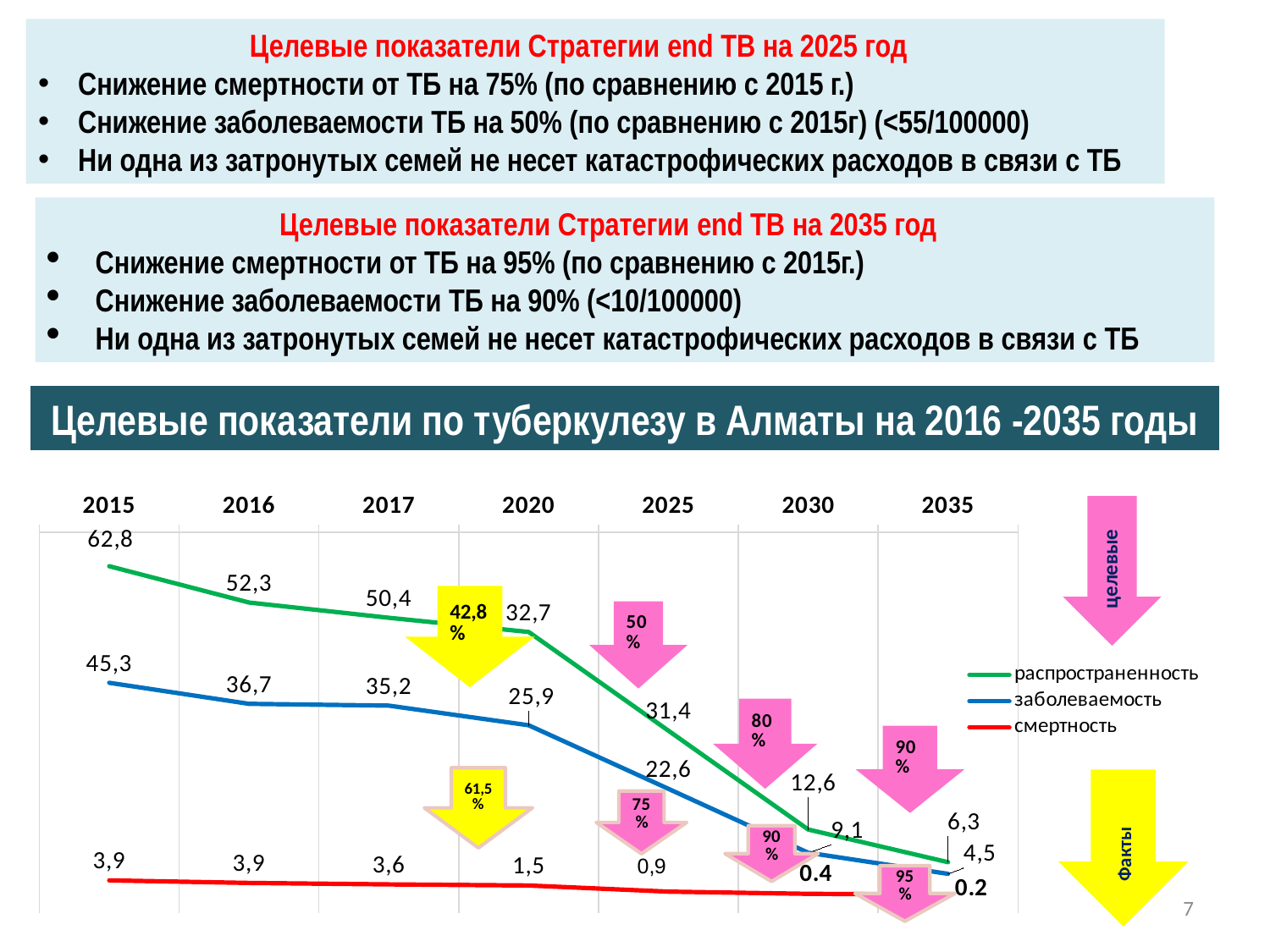
Do the values of заболеваемость rise or fall from 2015 to 2035? fall Which is larger in 2017: распространенность or заболеваемость? распространенность In which year is смертность at its lowest? 2035 What is the value of заболеваемость in 2035? 4,5 What is the value of заболеваемость in 2020? 25,9 What is the value of распространенность in 2015? 62,8 In which year is распространенность at its highest? 2015 How many series does the chart legend list? 3 What type of chart is shown on the slide? line chart What is the difference between распространенность in 2015 and in 2016? 10,5 How many years are shown along the x axis of the chart? 7 What is the value of смертность in 2035? 0.2